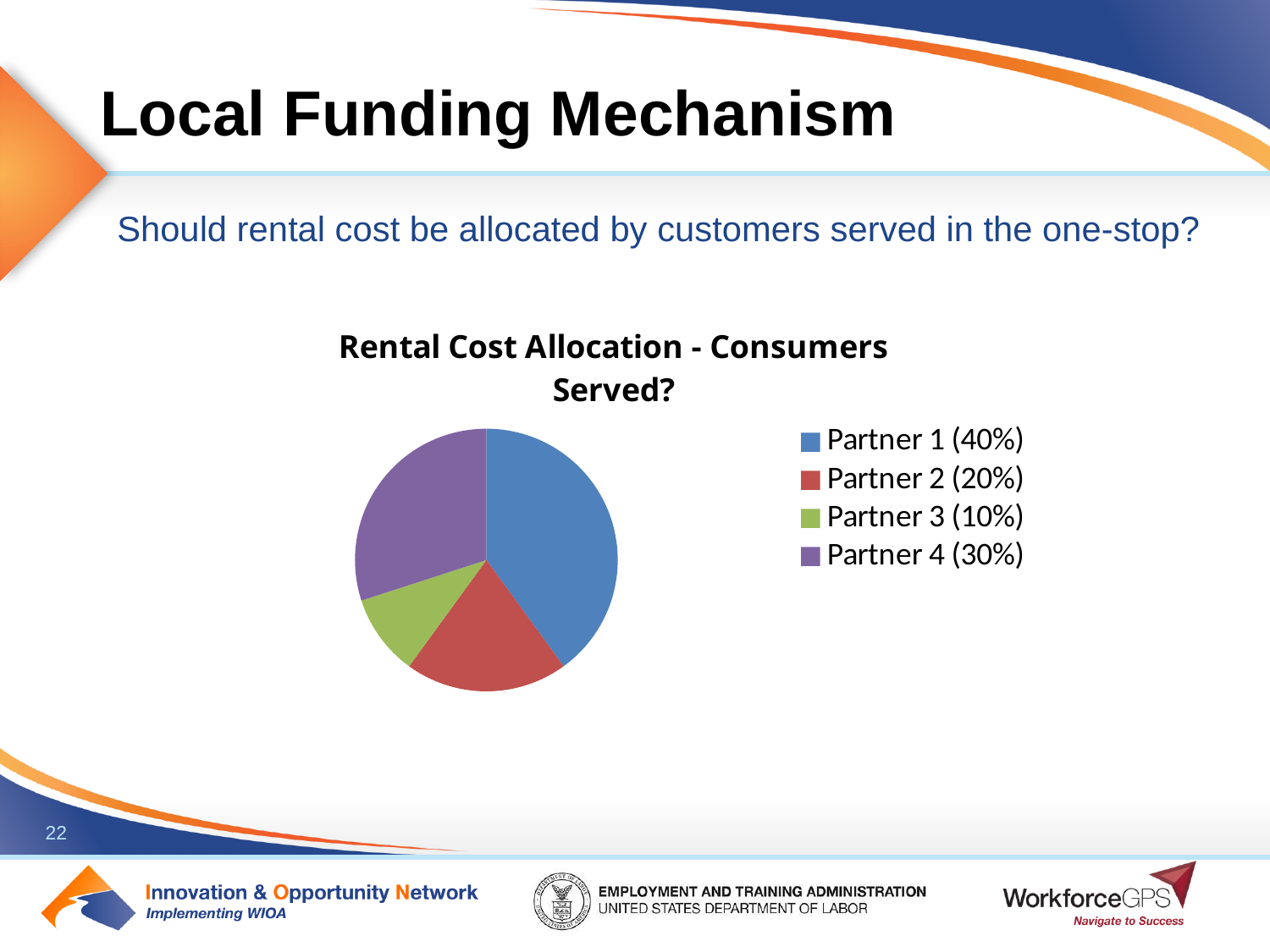
What share of the pie does Partner 3 have? 10% What is the difference between the shares of Partner 1 and Partner 4? 10% How many partners are shown in the pie chart? 4 Which partner has the smallest share of the pie? Partner 3 Which has a larger share, Partner 2 or Partner 4? Partner 4 What kind of chart is shown on the slide? pie chart What share of the pie does Partner 4 have? 30% What share of the pie does Partner 2 have? 20% What colour is the slice for Partner 3? green What is the title of the chart? Rental Cost Allocation - Consumers Served? Which partner has the largest share of the pie? Partner 1